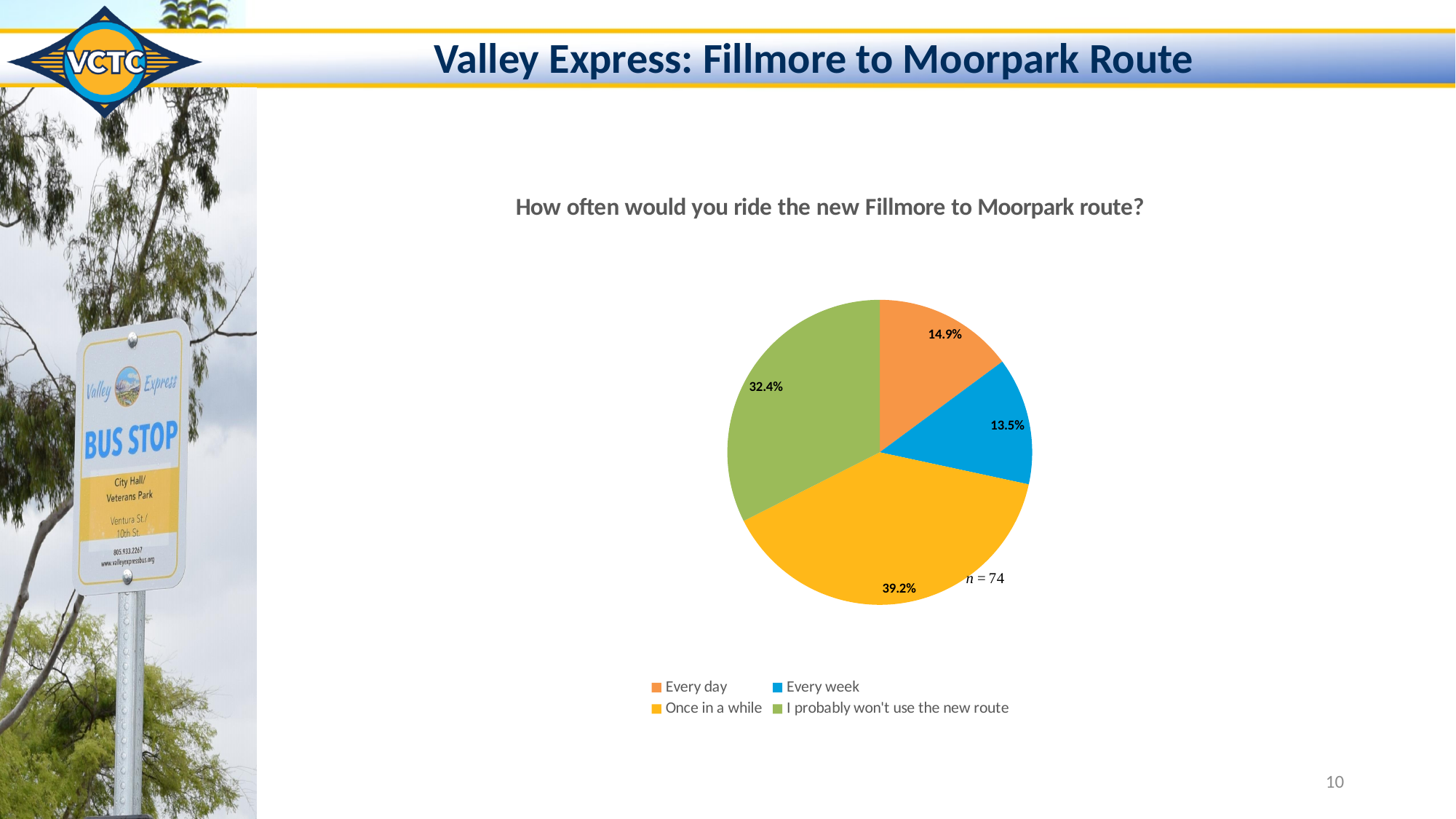
How many response categories are shown in the pie chart? 4 What percentage of respondents said they would ride the new route every week? 13.5% What is the title of the chart? How often would you ride the new Fillmore to Moorpark route? Which response category has the largest share of the pie? Once in a while What percentage of respondents said they probably won't use the new route? 32.4% What percentage of respondents said they would ride the new route every day? 14.9% Which response category has the smallest share of the pie? Every week What is the sample size (n) shown on the chart? 74 What percentage of respondents said they would ride the new route once in a while? 39.2% What type of chart is shown on the slide? Pie chart Which is larger: the share for 'Every day' or the share for 'Every week'? Every day What is the difference in percentage points between 'Once in a while' and 'I probably won't use the new route'? 6.8